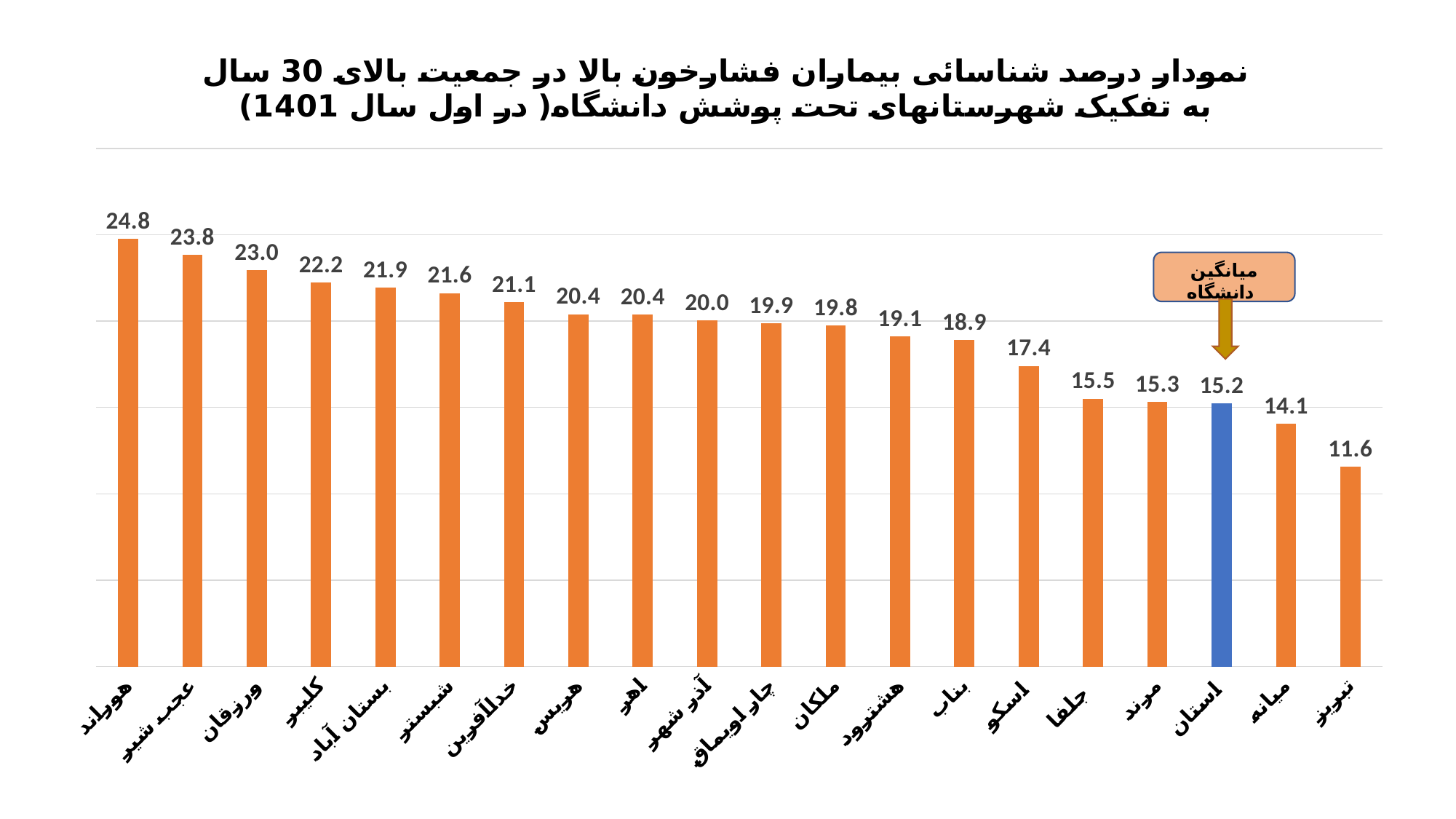
What type of chart is shown on the slide? Bar chart Which bar is coloured blue instead of orange? استان What is the difference between the values for هوراند and تبریز? 13.2 What is the value shown for هوراند? 24.8 Which category has the highest value in the chart? هوراند What is the value shown for اسکو? 17.4 Do the values rise or fall moving from left to right along the x axis? Fall What is the value shown for استان (the blue bar)? 15.2 What is the value shown for تبریز? 11.6 Which category has the lowest value in the chart? تبریز Which is larger, the value for جلفا or the value for میانه? جلفا How many bars (categories) are plotted in the chart? 20